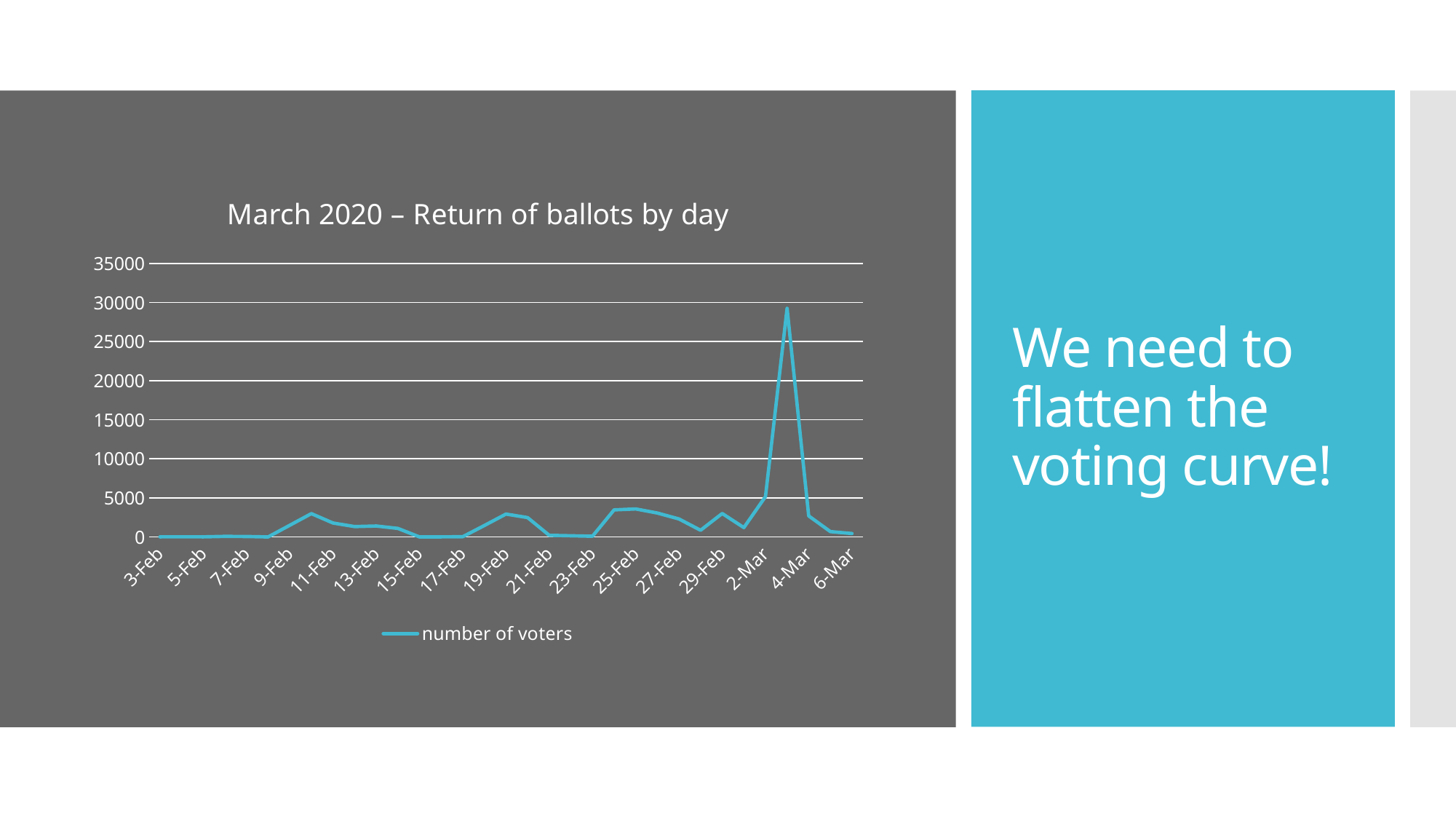
What is the maximum value shown on the vertical axis? 35000 What kind of chart is shown on the slide? line chart What is the title of the chart? March 2020 – Return of ballots by day What is the name of the series shown in the legend? number of voters How many series does the chart legend list? 1 Is the value for 11-Feb greater or less than 5000? less Is the highest value on the line greater or less than 25000? greater Is the highest value on the line greater or less than 30000? less How many date labels are shown along the x axis? 17